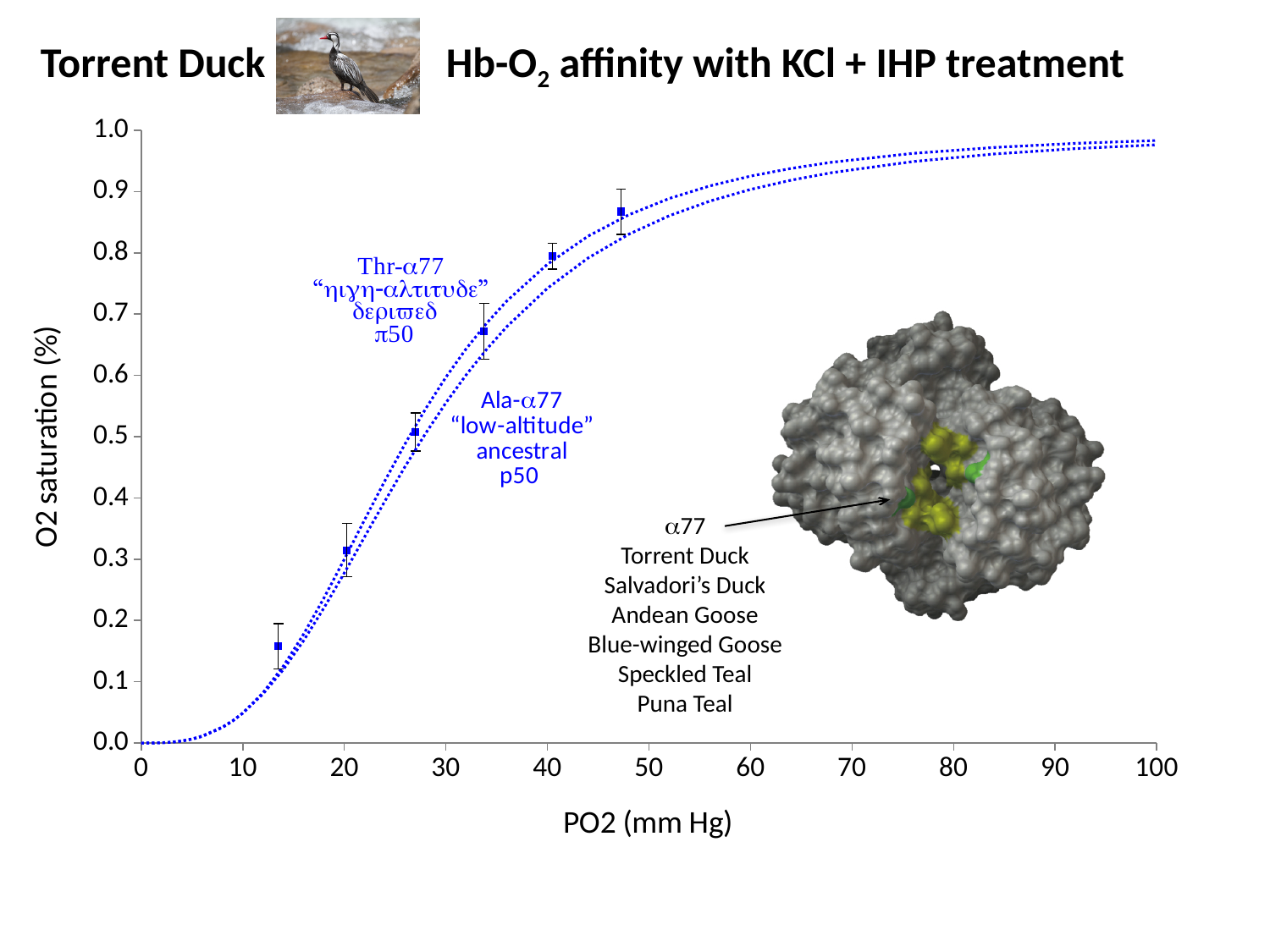
Is the O2 saturation of the data point near PO2 = 40 mm Hg greater or less than 0.7? greater What kind of chart is shown on the slide? line chart How many data points with error bars are plotted on the chart? 6 Does O2 saturation rise or fall as PO2 increases along the x axis? rise What is the title of the chart? Hb-O2 affinity with KCl + IHP treatment How many dotted curves are plotted on the chart? 2 What is the maximum value shown on the y axis? 1.0 What is the label of the x axis? PO2 (mm Hg) Is the O2 saturation of the data point near PO2 = 47 mm Hg greater or less than 0.8? greater At PO2 = 30 mm Hg, which curve shows the higher O2 saturation, Thr-α77 or Ala-α77? Thr-α77 Is the O2 saturation of the data point near PO2 = 34 mm Hg greater or less than 0.6? greater